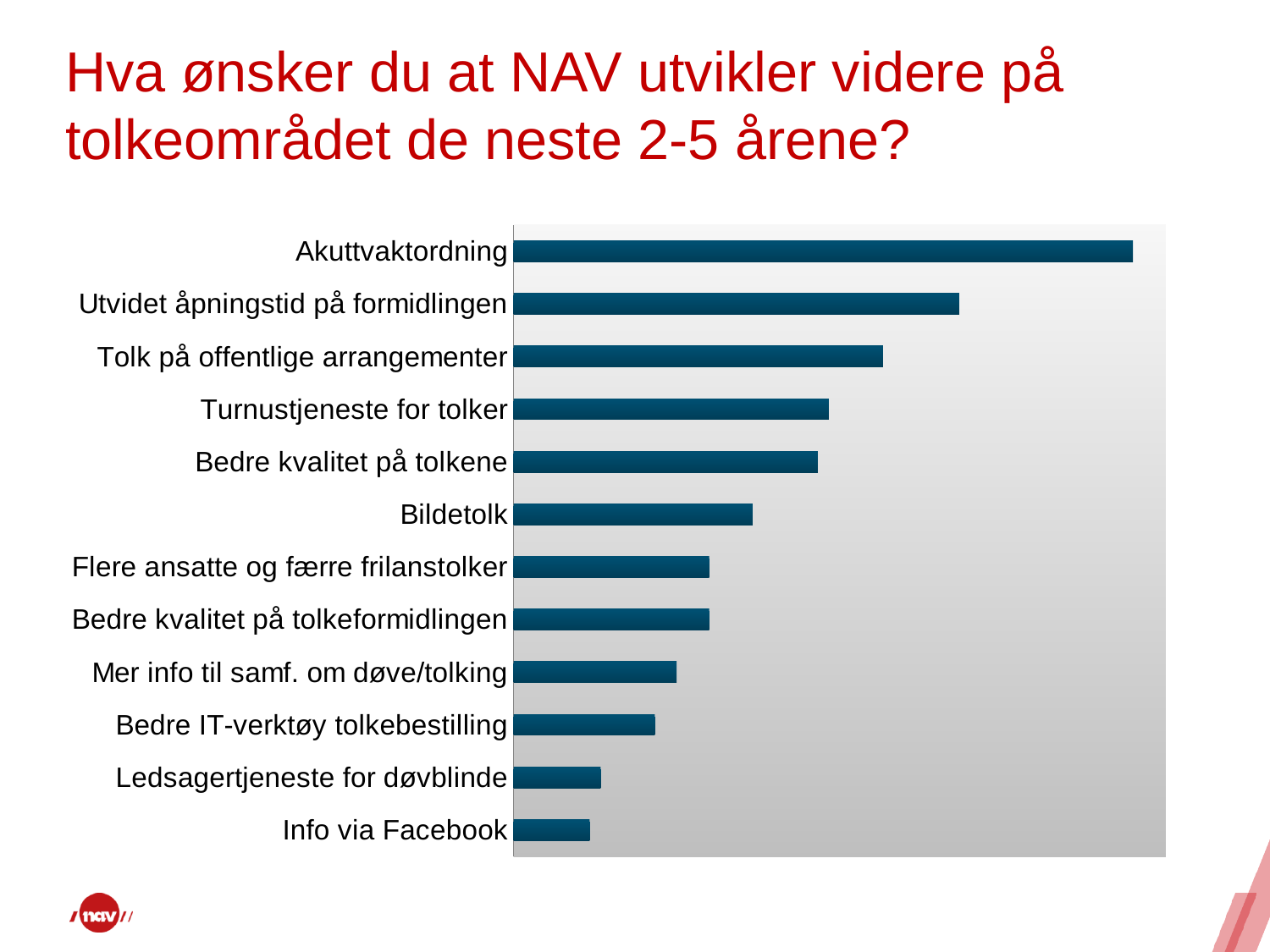
How many categories are shown in the chart? 12 Which category has the longest bar? Akuttvaktordning Which has the larger value: Bildetolk or Ledsagertjeneste for døvblinde? Bildetolk Which category is listed second from the top in the chart? Utvidet åpningstid på formidlingen Which has the larger value: Akuttvaktordning or Info via Facebook? Akuttvaktordning What kind of chart is shown on the slide? Bar chart Do the bar lengths generally increase or decrease going from the top category to the bottom category? Decrease Which has the larger value: Utvidet åpningstid på formidlingen or Tolk på offentlige arrangementer? Utvidet åpningstid på formidlingen Which category has the shortest bar? Info via Facebook What is the title of the slide containing the chart? Hva ønsker du at NAV utvikler videre på tolkeområdet de neste 2-5 årene?